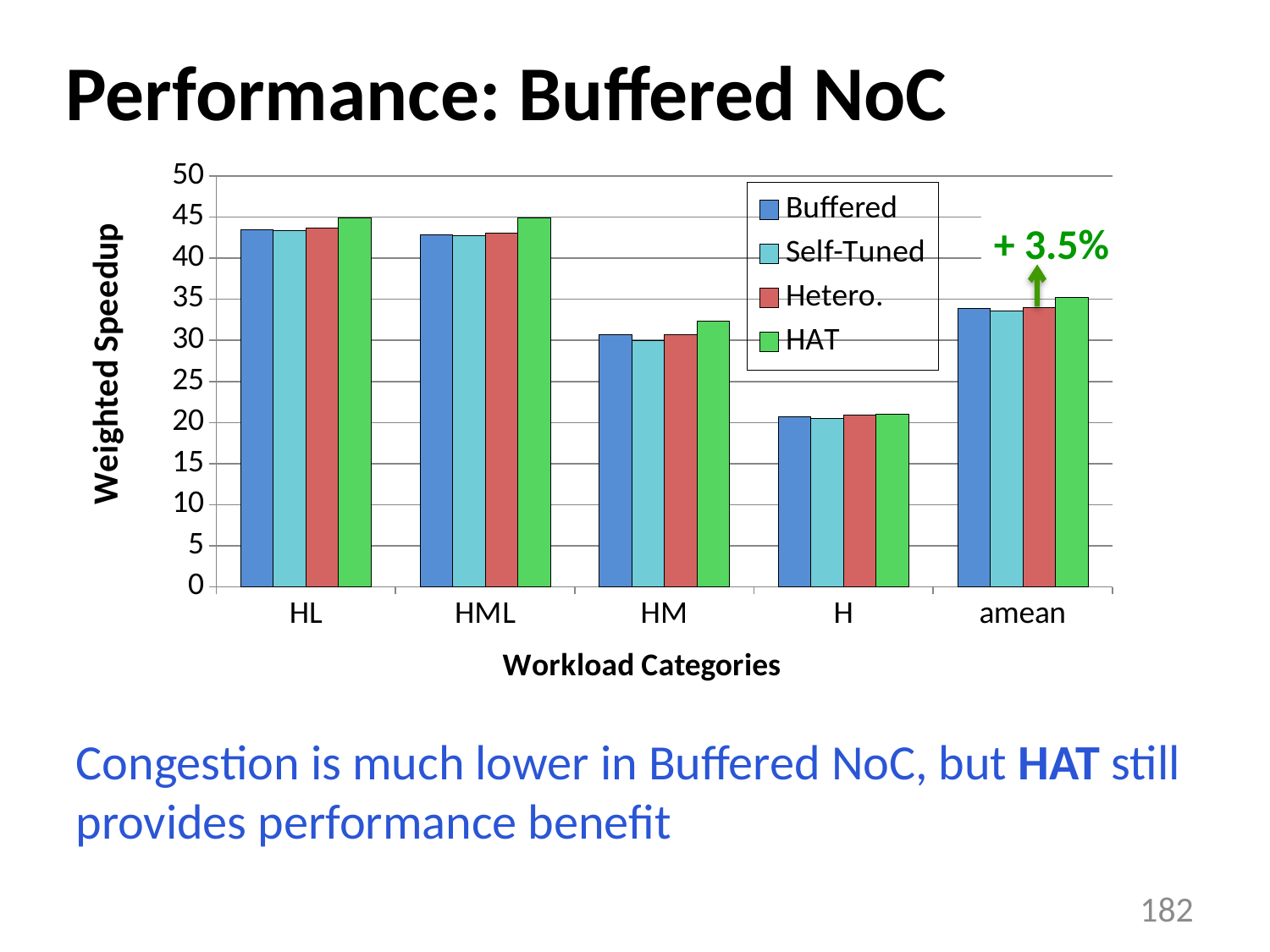
Which has the larger weighted speedup for HAT: HL or H? HL Is the weighted speedup for HAT in the HM category greater or less than 30? greater What is the label of the y axis? Weighted Speedup Is the weighted speedup for HAT in the amean category greater or less than 40? less How many workload categories are shown on the x axis? 5 Is the weighted speedup for Buffered in the HL category greater or less than 40? greater How many series does the legend list? 4 Which workload category has the lowest weighted speedup? H What kind of chart is shown on the slide? bar chart What percentage improvement is annotated above the amean category? + 3.5% Do the weighted speedup values rise or fall going from HL to H along the x axis? fall